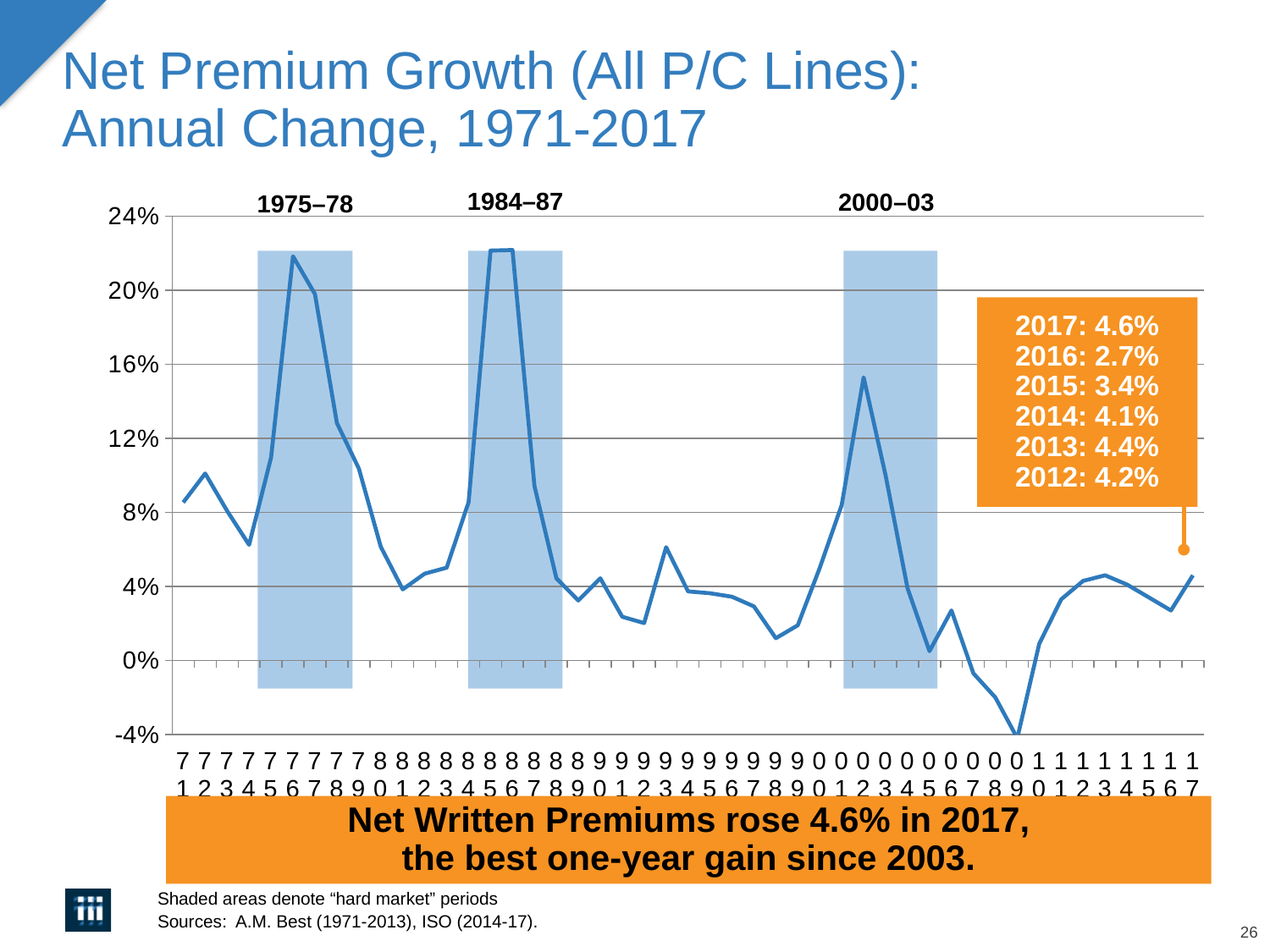
Which year had higher net premium growth, 2014 or 2015? 2014 Is the net premium growth value for 1985 greater or less than 20%? greater How many shaded "hard market" periods are marked on the chart? 3 Among the years 2012 to 2017 listed in the callout box, which year had the highest net premium growth? 2017 What kind of chart is shown on the slide? Line chart By how many percentage points did net premium growth in 2017 exceed that of 2016? 1.9 percentage points What was the net premium growth in 2017? 4.6% What was the net premium growth in 2012? 4.2% What was the net premium growth in 2016? 2.7% Among the years 2012 to 2017 listed in the callout box, which year had the lowest net premium growth? 2016 Is the net premium growth value for 2002 greater or less than 12%? greater Is the net premium growth value for 2009 greater or less than 0%? less